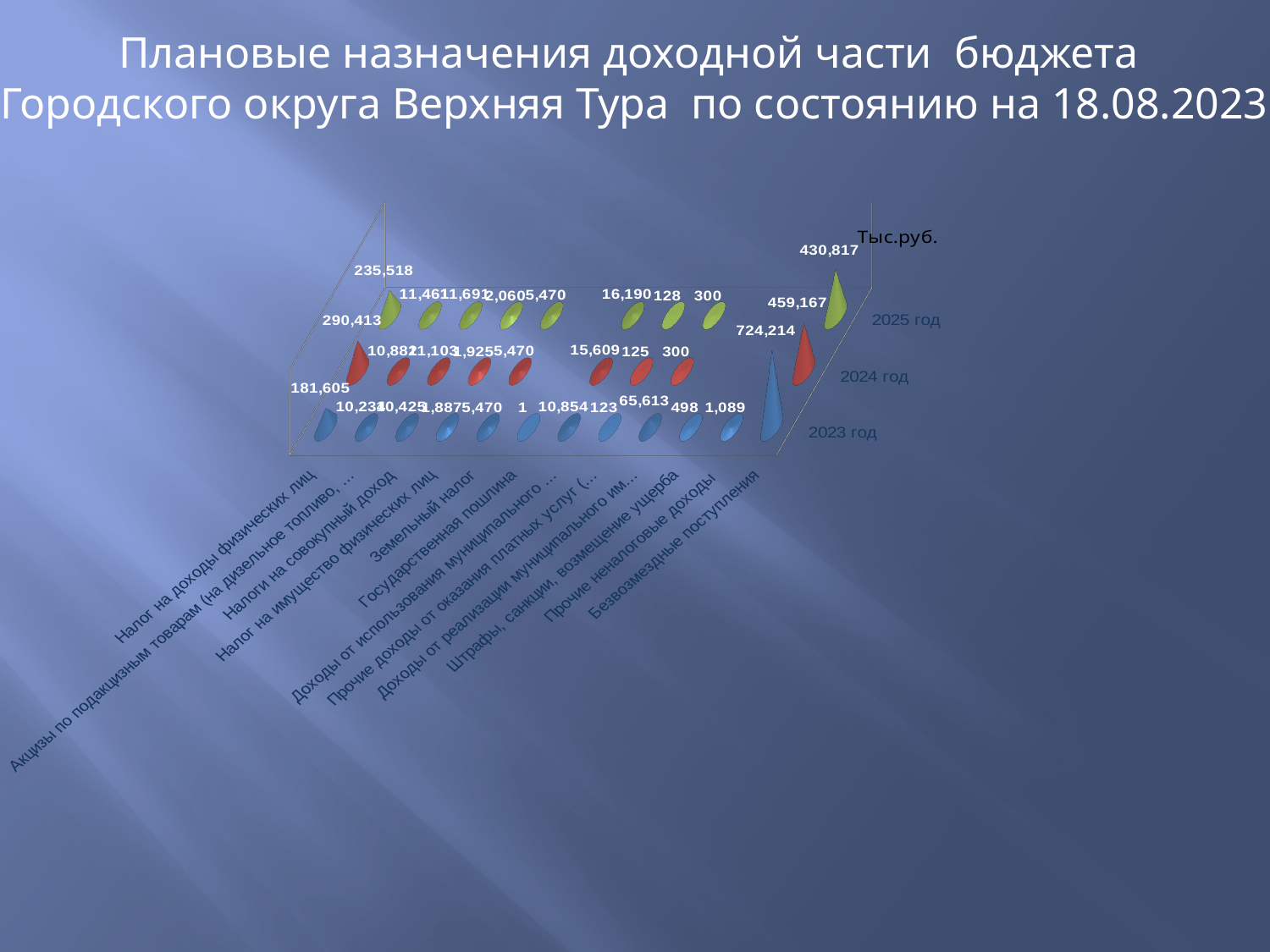
What is the 2023 год value for Земельный налог? 5,470 What is the 2023 год value for Безвозмездные поступления? 724,214 How many series does the chart show? 3 What unit is indicated in the top-right corner of the chart? Тыс.руб. What is the 2025 год value for Безвозмездные поступления? 430,817 Do the values for Безвозмездные поступления rise or fall from 2023 год to 2025 год? fall Which category has the highest value in the 2023 год series? Безвозмездные поступления What is the 2024 год value for Безвозмездные поступления? 459,167 What is the 2023 год value for Налог на доходы физических лиц? 181,605 Which is larger for Налог на доходы физических лиц: the 2024 год value or the 2025 год value? 2024 год What is the difference between the 2023 год values for Безвозмездные поступления and Налог на доходы физических лиц? 542,609 What is the 2024 год value for Налог на доходы физических лиц? 290,413